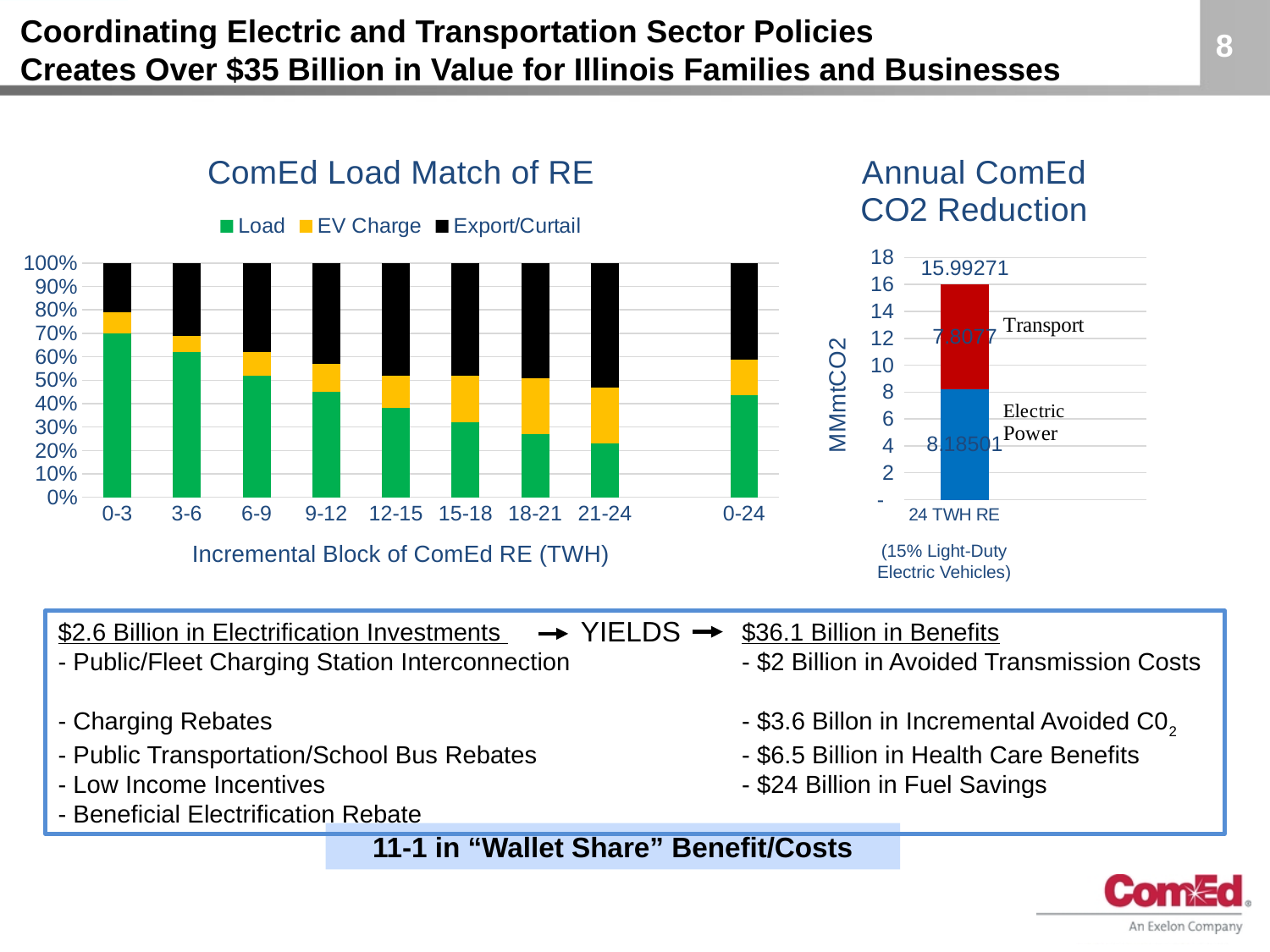
What kind of chart is the "ComEd Load Match of RE" chart? bar chart In the "ComEd Load Match of RE" chart, is the Load value for the 21-24 block greater or less than 30%? less In the "Annual ComEd CO2 Reduction" chart, which is larger, Electric Power or Transport? Electric Power In the "ComEd Load Match of RE" chart, is the Load value for the 0-3 block greater or less than 60%? greater In the "Annual ComEd CO2 Reduction" chart, what is the value for Electric Power? 8.18501 In the "Annual ComEd CO2 Reduction" chart, what is the value for Transport? 7.8077 In the "Annual ComEd CO2 Reduction" chart, what is the total of the 24 TWH RE bar? 15.99271 How many categories are shown on the x axis of the "ComEd Load Match of RE" chart? 9 How many series does the legend of the "ComEd Load Match of RE" chart list? 3 What is the y-axis label of the "Annual ComEd CO2 Reduction" chart? MMmtCO2 In the "ComEd Load Match of RE" chart, which block has the highest Load share? 0-3 In the "ComEd Load Match of RE" chart, does the Load share rise or fall from the 0-3 block to the 21-24 block? fall